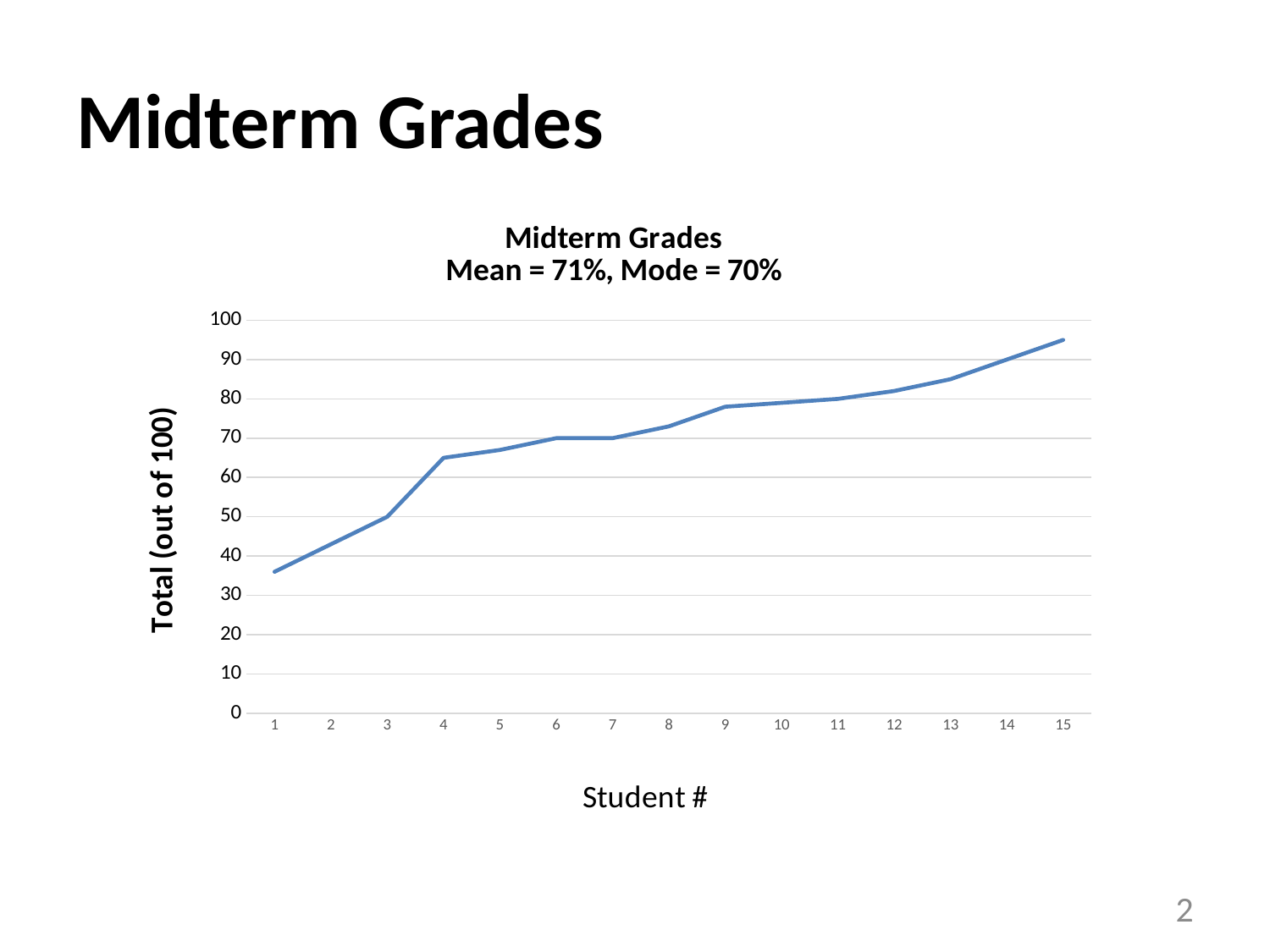
What kind of chart is shown on the slide? line chart Is the value for student 15 greater or less than 90? greater How many students are plotted on the x axis? 15 Is the value for student 4 greater or less than 60? greater Do the grades rise or fall as the student number increases along the x axis? rise What is the title of the chart? Midterm Grades Mean = 71%, Mode = 70% Is the value for student 13 greater or less than 80? greater What is the label on the y axis? Total (out of 100) Which has the larger value, student 4 or student 9? student 9 Which student number has the highest grade? 15 Which student number has the lowest grade? 1